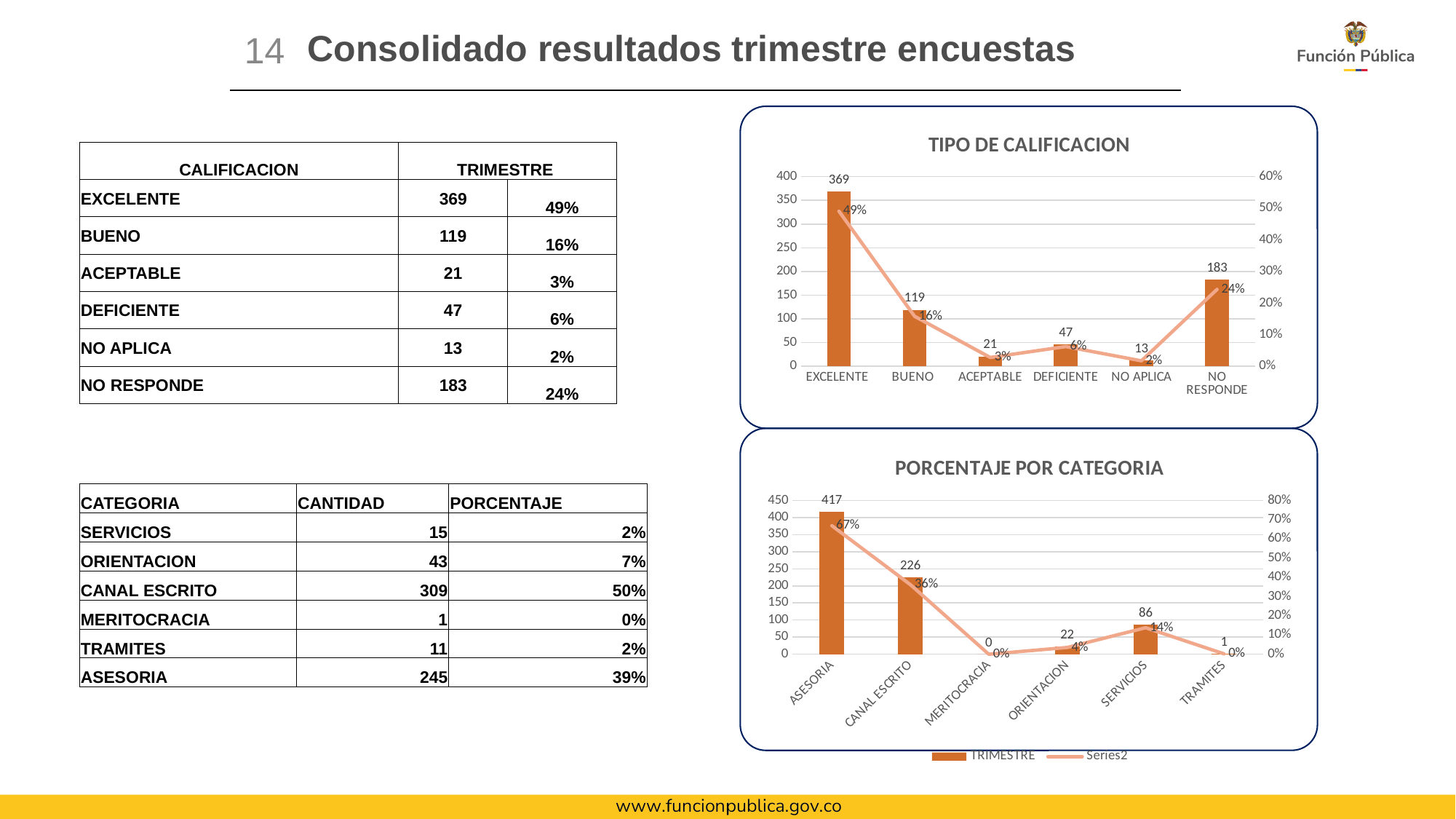
What kind of chart is the TIPO DE CALIFICACION chart? A combined bar and line chart In the TIPO DE CALIFICACION chart, which has a larger bar value, BUENO or DEFICIENTE? BUENO How many categories are shown on the x axis of the TIPO DE CALIFICACION chart? 6 In the PORCENTAJE POR CATEGORIA chart, what percentage is shown for ASESORIA? 67% In the TIPO DE CALIFICACION chart, what is the bar value for EXCELENTE? 369 In the PORCENTAJE POR CATEGORIA chart, what is the bar value for CANAL ESCRITO? 226 In the TIPO DE CALIFICACION chart, which category has the lowest bar value? NO APLICA In the PORCENTAJE POR CATEGORIA chart, which category has the highest bar value? ASESORIA How many series does the legend of the PORCENTAJE POR CATEGORIA chart list? 2 In the PORCENTAJE POR CATEGORIA chart, what is the difference between the bar values for SERVICIOS and ORIENTACION? 64 In the TIPO DE CALIFICACION chart, what percentage is shown for NO RESPONDE? 24% In the TIPO DE CALIFICACION chart, what is the difference between the bar values for EXCELENTE and NO RESPONDE? 186